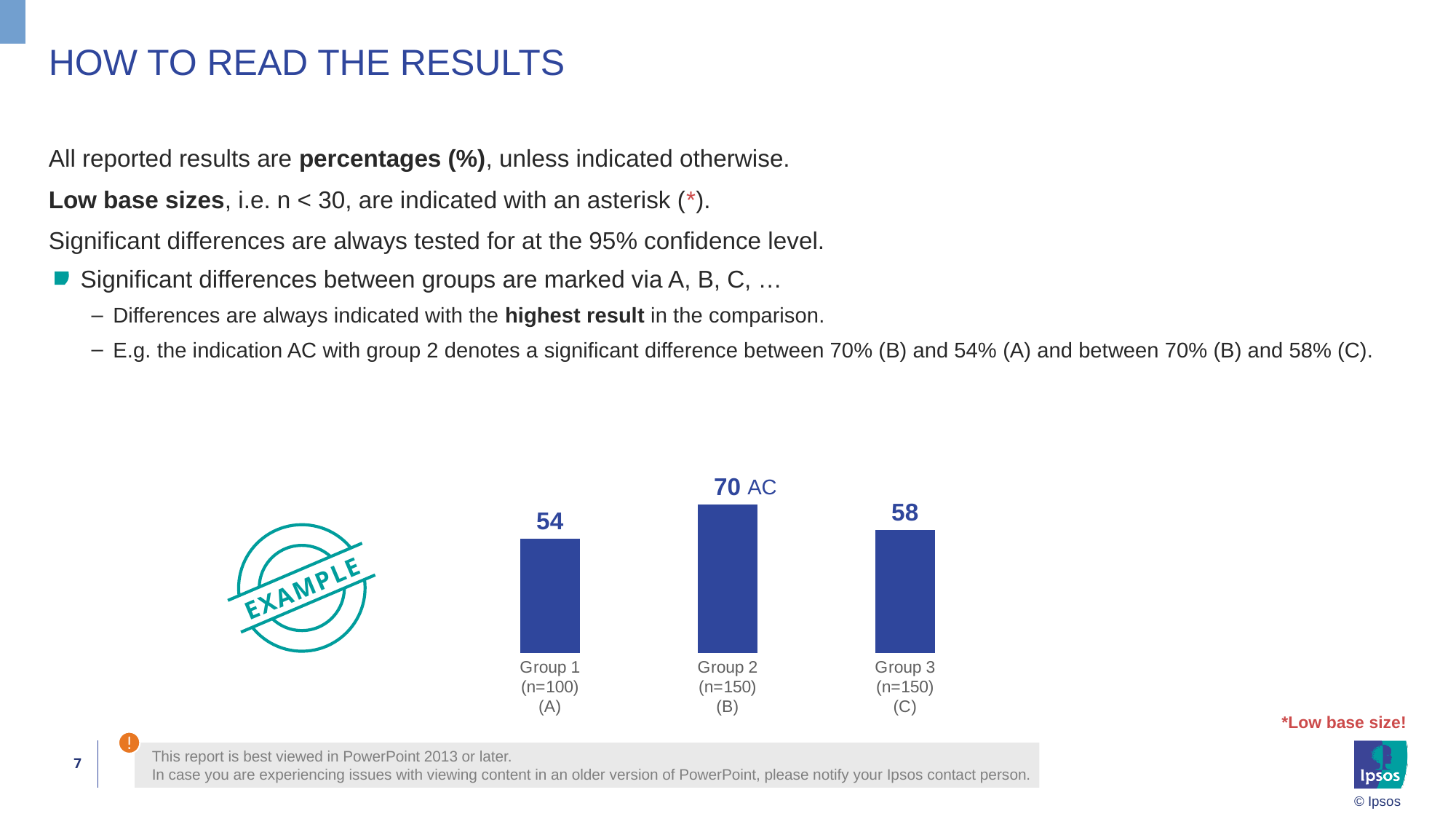
Which group has the highest value? Group 2 What is the difference between the values for Group 2 and Group 1? 16 What is the base size (n) shown for Group 1? n=100 Which group has the lowest value? Group 1 What kind of chart is shown on the slide? Bar chart Which significance letters are marked next to the value for Group 2? AC What is the value for Group 1 (n=100) (A)? 54 What is the value for Group 3 (n=150) (C)? 58 How many groups are shown in the chart? 3 What is the value for Group 2 (n=150) (B)? 70 Which is larger, the value for Group 2 or the value for Group 3? Group 2 What is the difference between the values for Group 3 and Group 1? 4